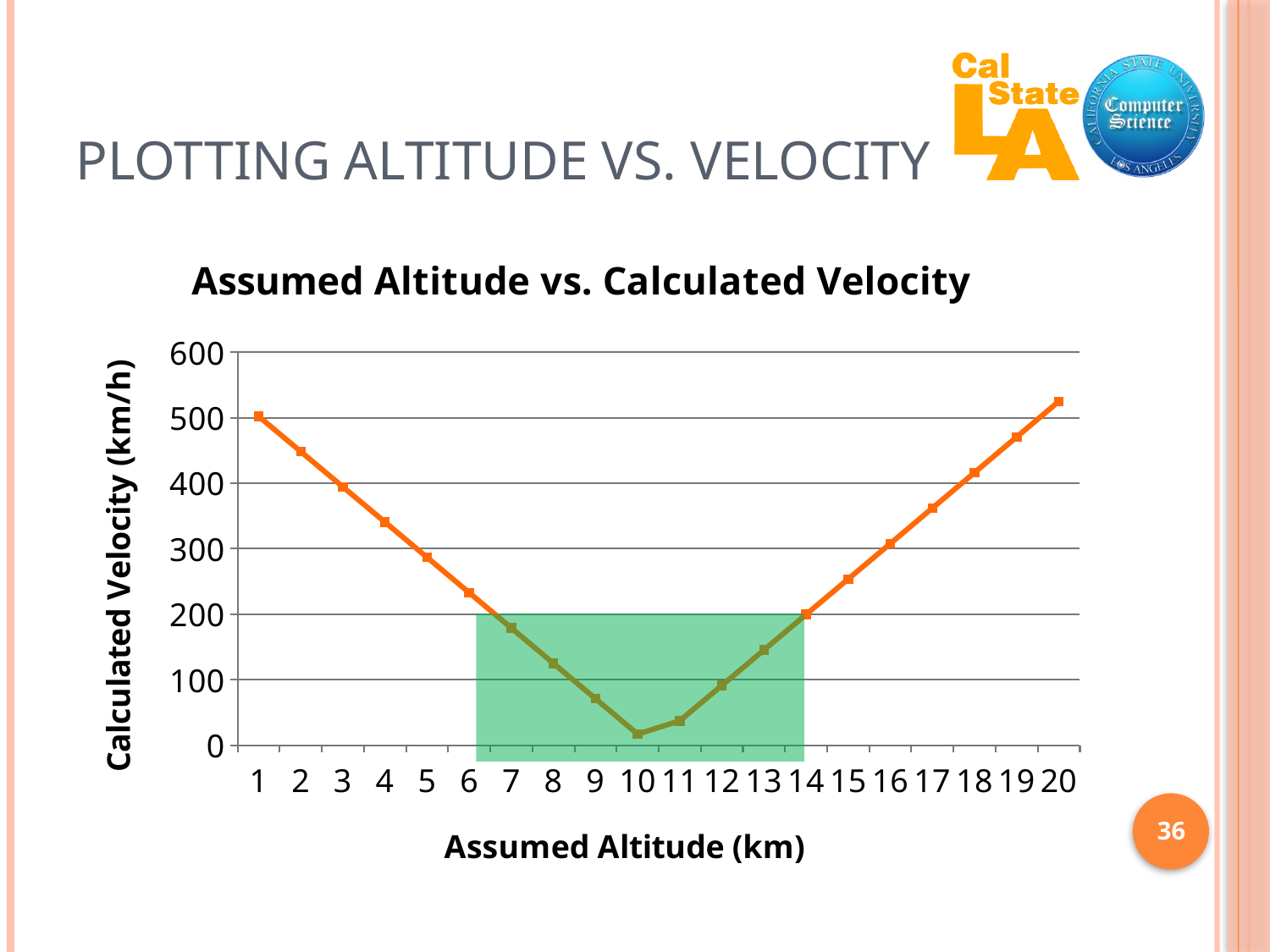
Which has the larger calculated velocity: an assumed altitude of 7 km or 13 km? 7 km Is the calculated velocity at an assumed altitude of 10 km greater or less than 100? less Is the calculated velocity at an assumed altitude of 2 km greater or less than 400? greater Is the calculated velocity at an assumed altitude of 8 km greater or less than 100? greater What kind of chart is shown on the slide? line chart How many altitude values are plotted along the x axis? 20 At which assumed altitude is the calculated velocity highest? 20 Does the calculated velocity rise or fall as the assumed altitude increases from 10 km to 20 km? rise What is the title of the chart? Assumed Altitude vs. Calculated Velocity What is the label of the vertical axis? Calculated Velocity (km/h) At which assumed altitude is the calculated velocity lowest? 10 Does the calculated velocity rise or fall as the assumed altitude increases from 1 km to 10 km? fall